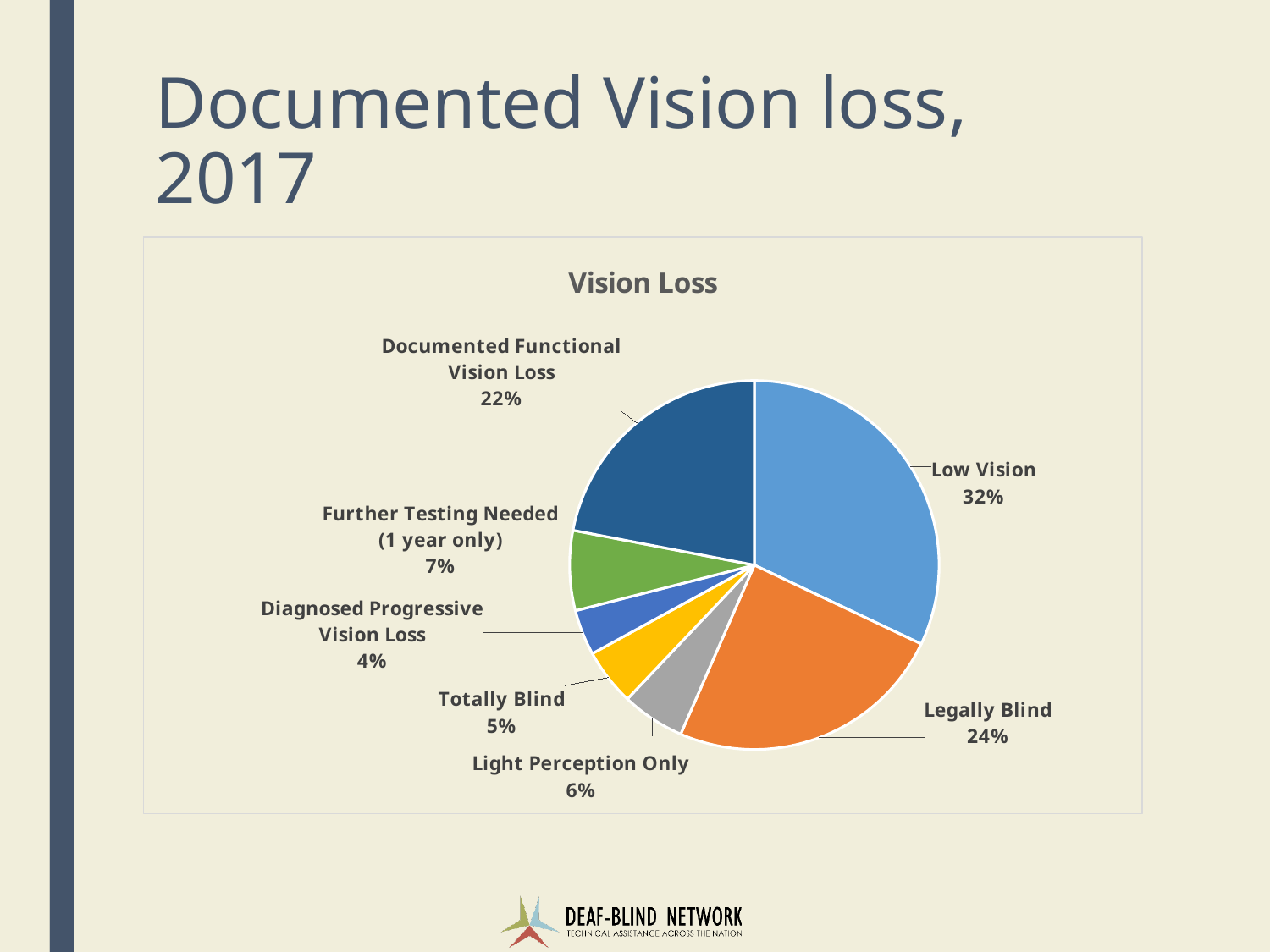
What percentage is shown for Light Perception Only? 6% What percentage is shown for Legally Blind? 24% What percentage is shown for Further Testing Needed (1 year only)? 7% What is the difference in percentage points between Low Vision and Legally Blind? 8 What kind of chart is shown on the slide? pie chart What share of the pie is Low Vision? 32% Which category has the smallest slice of the pie? Diagnosed Progressive Vision Loss What percentage is shown for Documented Functional Vision Loss? 22% Which is larger, Totally Blind or Light Perception Only? Light Perception Only How many categories are shown in the pie chart? 7 Which category has the largest slice of the pie? Low Vision What is the title of the chart? Vision Loss